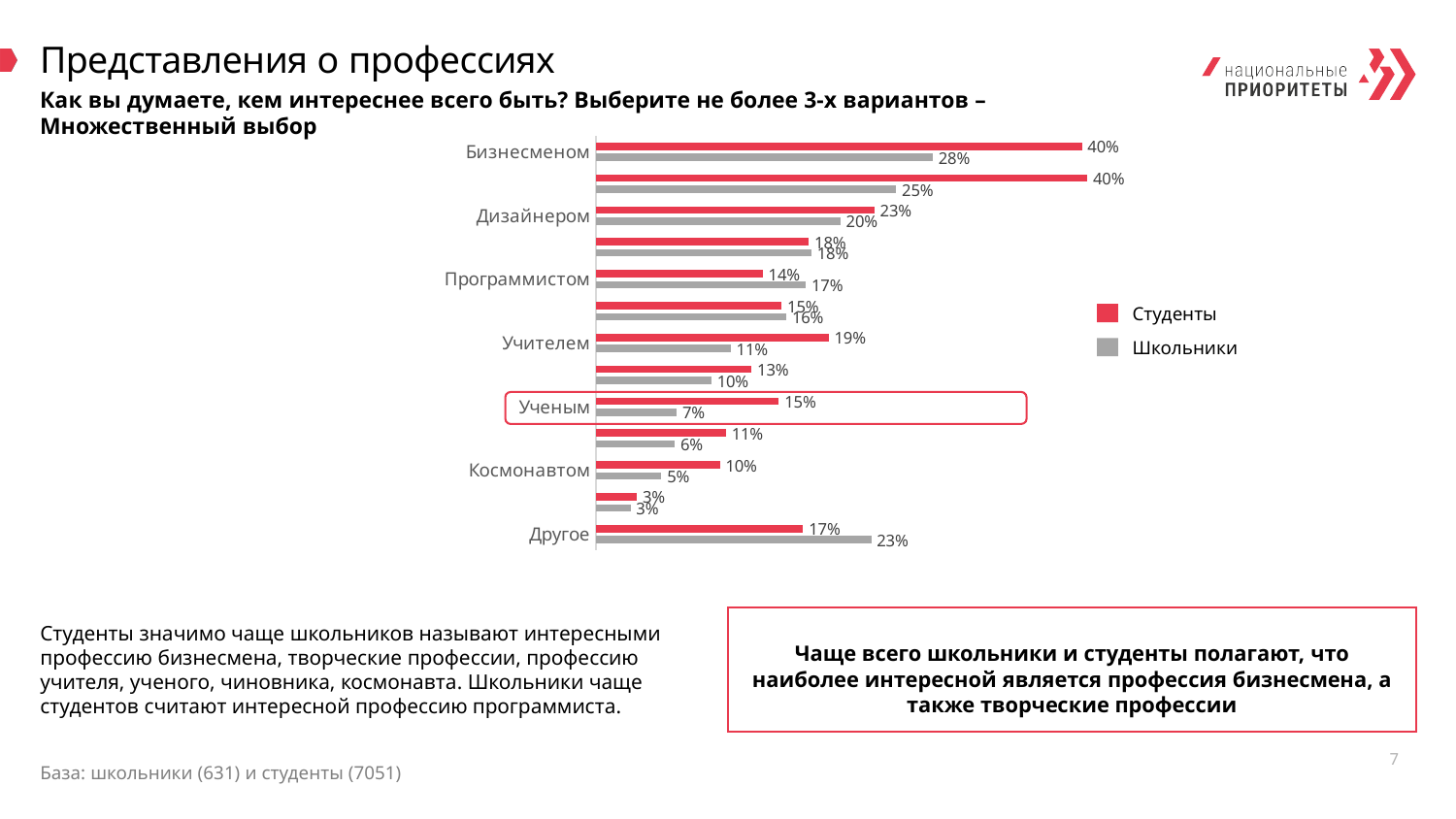
What is the value for Школьники for Ученым? 7% For Другое, which series has the larger value, Студенты or Школьники? Школьники How many series does the legend list? 2 Which has the higher Школьники value, Ученым or Космонавтом? Ученым What is the value for Студенты for Космонавтом? 10% What is the value for Студенты for Ученым? 15% What is the value for Школьники for Бизнесменом? 28% What kind of chart is shown on the slide? Bar chart What is the difference between the Студенты and Школьники values for Учителем? 8% For Программистом, which series has the larger value, Студенты or Школьники? Школьники What is the difference between the Школьники and Студенты values for Другое? 6% What is the value for Студенты for Бизнесменом? 40%